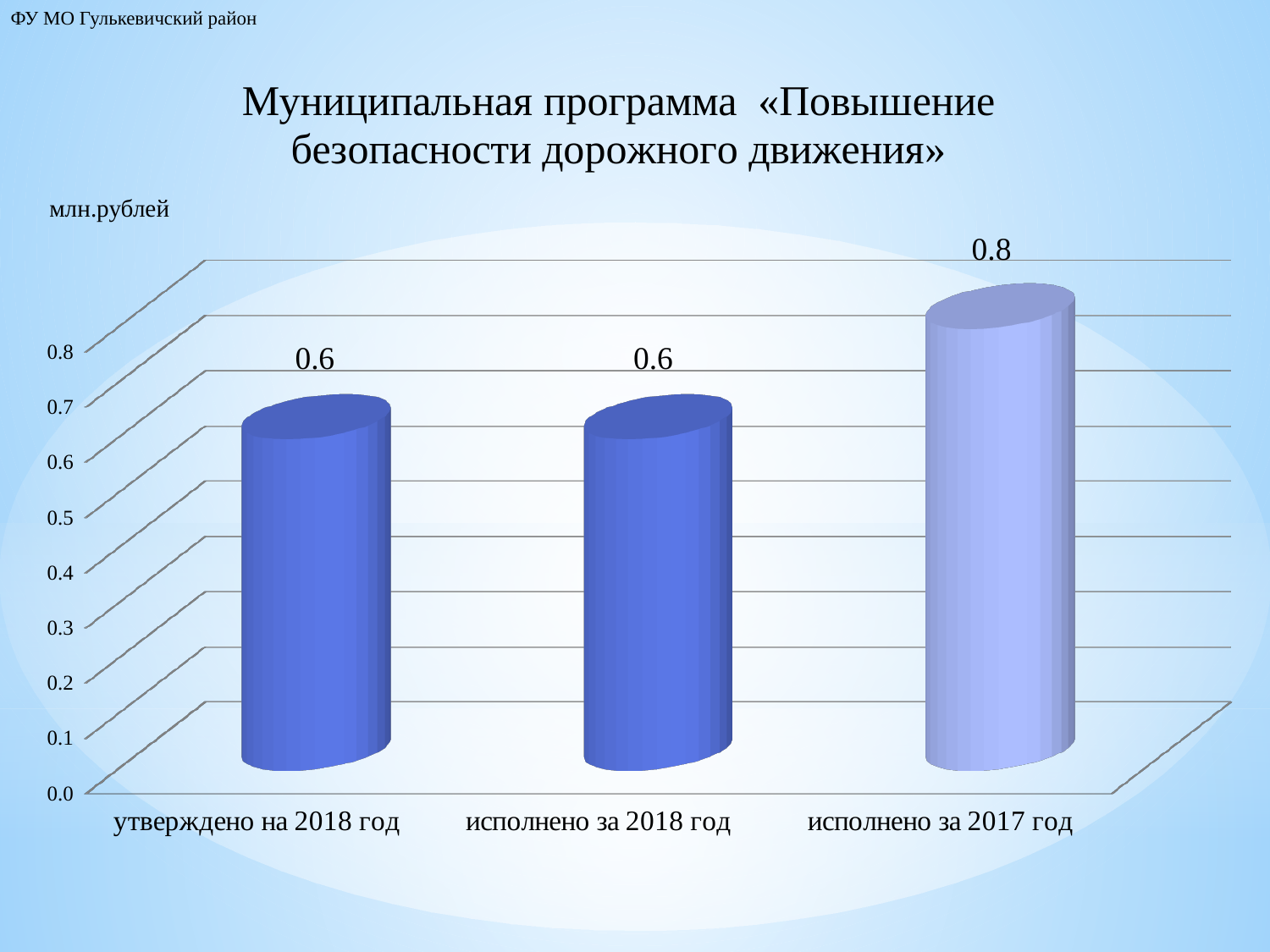
What unit of measurement is indicated above the chart? млн.рублей Which is larger: the value for «исполнено за 2017 год» or the value for «утверждено на 2018 год»? исполнено за 2017 год What is the title of the municipal program shown on the slide? «Повышение безопасности дорожного движения» How many categories are shown on the chart? 3 What is the value for «исполнено за 2017 год»? 0.8 What is the difference between the values for «исполнено за 2017 год» and «исполнено за 2018 год»? 0.2 What is the value for «исполнено за 2018 год»? 0.6 Is the value for «утверждено на 2018 год» greater or less than 0.7? less What is the value for «утверждено на 2018 год»? 0.6 What kind of chart is shown on the slide? bar chart Is the value for «исполнено за 2017 год» greater or less than 0.7? greater Which category has the highest value? исполнено за 2017 год